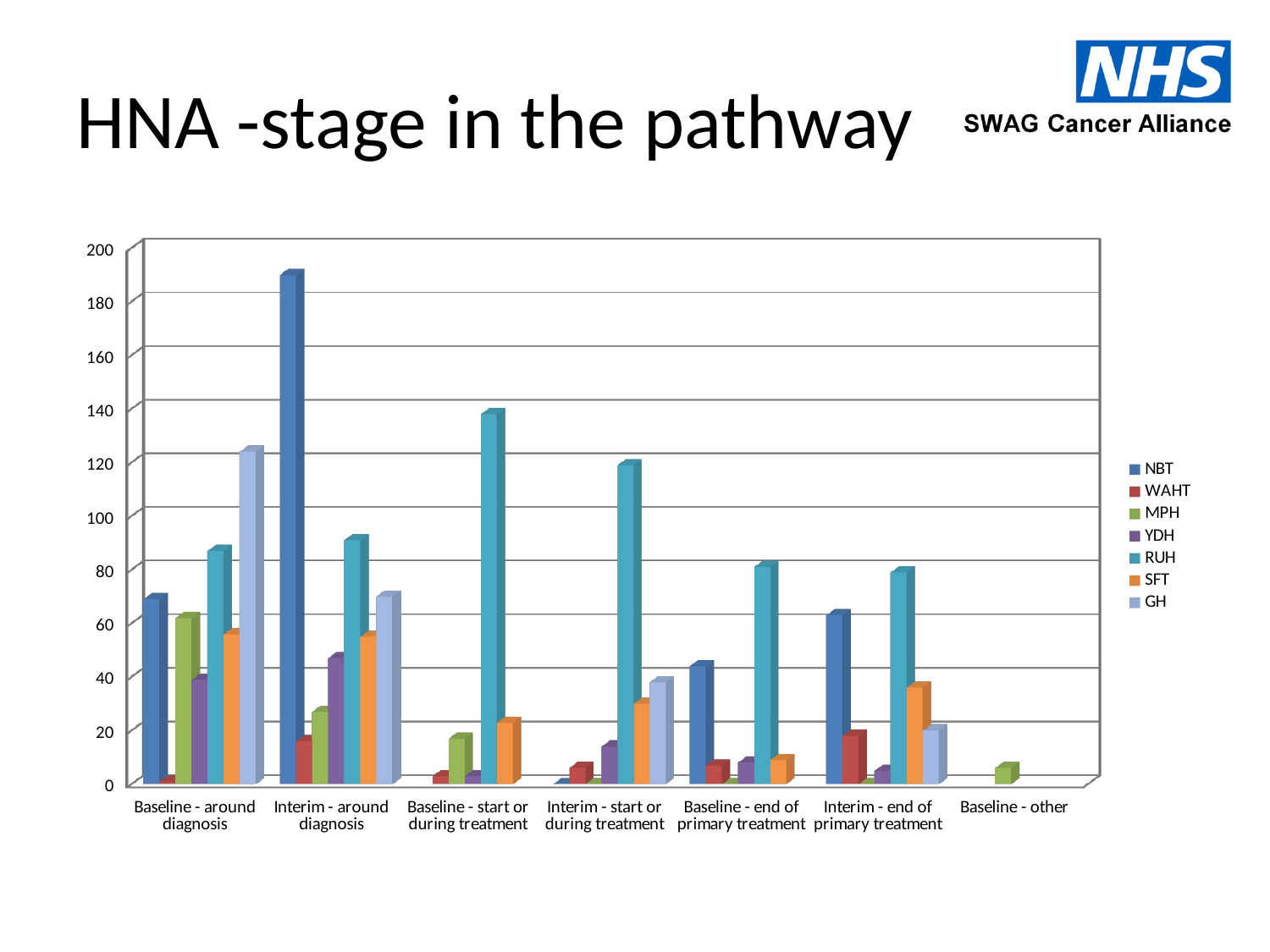
What is the title of the slide containing the chart? HNA -stage in the pathway Which is larger in the 'Baseline - end of primary treatment' category: the value for NBT or the value for RUH? RUH Is the value for GH in 'Baseline - around diagnosis' greater or less than 100? greater Is the value for NBT in 'Interim - around diagnosis' greater or less than 180? greater Which series is the only one with a visible bar in the 'Baseline - other' category? MPH What kind of chart is shown on the slide? bar chart Which series has the highest value in the 'Baseline - around diagnosis' category? GH How many series does the legend list? 7 How many categories are shown along the x axis of the chart? 7 Which series has the highest value in the 'Interim - around diagnosis' category? NBT Is the value for SFT in 'Interim - end of primary treatment' greater or less than 40? less